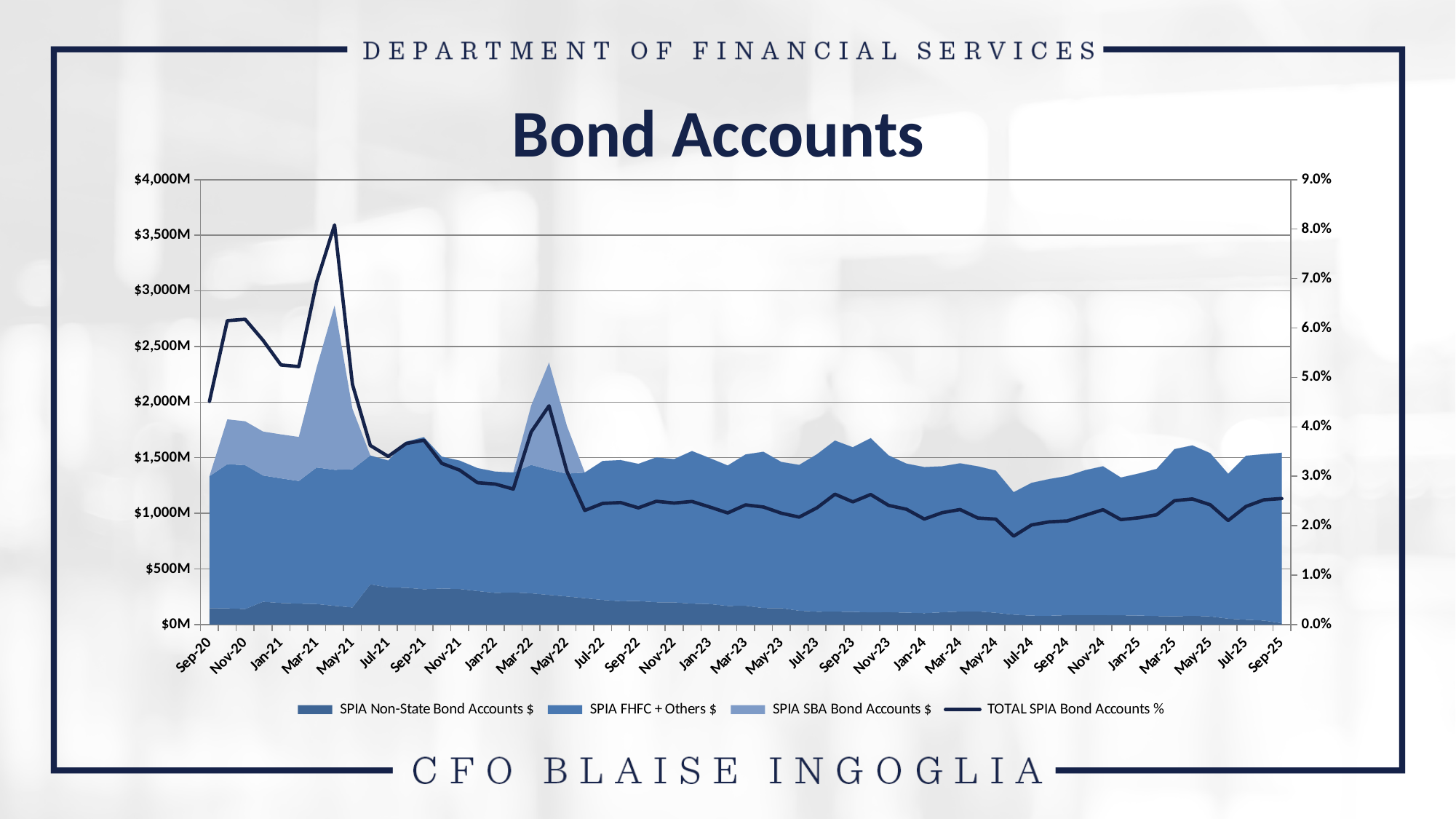
Is the TOTAL SPIA Bond Accounts % value at Sep-20 greater or less than 4.0%? greater How many series does the chart legend list? 4 Is the peak value of the TOTAL SPIA Bond Accounts % line greater or less than 7.0%? greater Is the TOTAL SPIA Bond Accounts % value at Sep-25 greater or less than 3.0%? less Which is larger, the TOTAL SPIA Bond Accounts % at Sep-20 or at Sep-25? Sep-20 What is the title of the chart? Bond Accounts What kind of chart is shown on the slide? Stacked area chart with a line Does the TOTAL SPIA Bond Accounts % line overall rise or fall from Sep-20 to Sep-25? fall What is the first month shown on the x axis? Sep-20 Which series is plotted as a line rather than a shaded area? TOTAL SPIA Bond Accounts %